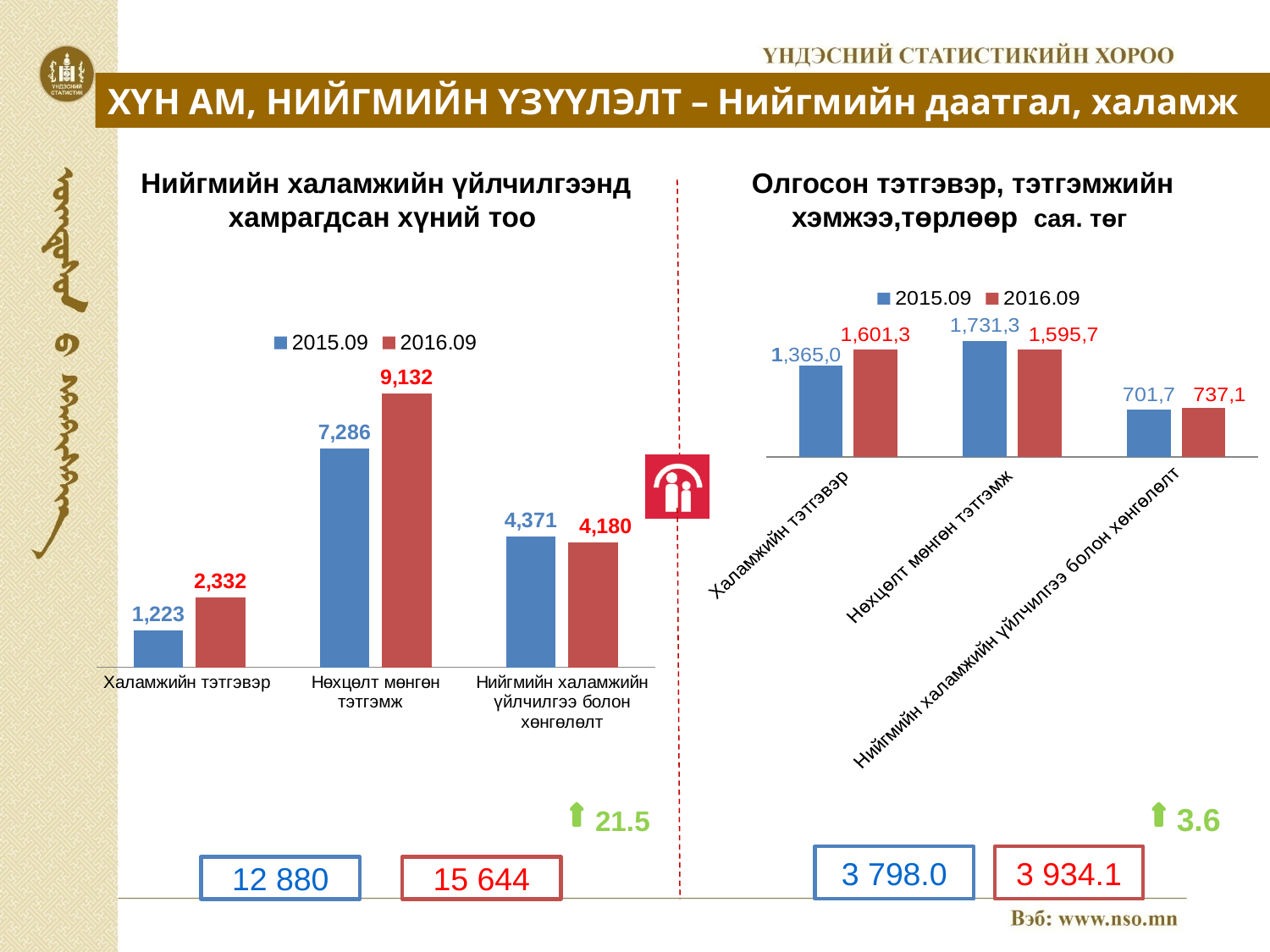
In the left chart, which category has the lowest value for 2015.09? Халамжийн тэтгэвэр In the left chart, what is the difference between the 2016.09 and 2015.09 values for Халамжийн тэтгэвэр? 1,109 In the left chart, is the 2015.09 or the 2016.09 value larger for Нийгмийн халамжийн үйлчилгээ болон хөнгөлөлт? 2015.09 In the right chart, what is the value for Нөхцөлт мөнгөн тэтгэмж in 2015.09? 1,731,3 How many categories are shown on the x axis of the right chart? 3 In the left chart, which category has the highest value for 2016.09? Нөхцөлт мөнгөн тэтгэмж What kind of chart is the left chart? Bar chart In the left chart, what is the value for Халамжийн тэтгэвэр in 2015.09? 1,223 In the right chart, what is the value for Нийгмийн халамжийн үйлчилгээ болон хөнгөлөлт in 2016.09? 737,1 In the right chart, which category has the lowest value for 2016.09? Нийгмийн халамжийн үйлчилгээ болон хөнгөлөлт How many series does the legend of the left chart list? 2 In the left chart, what is the value for Нөхцөлт мөнгөн тэтгэмж in 2016.09? 9,132